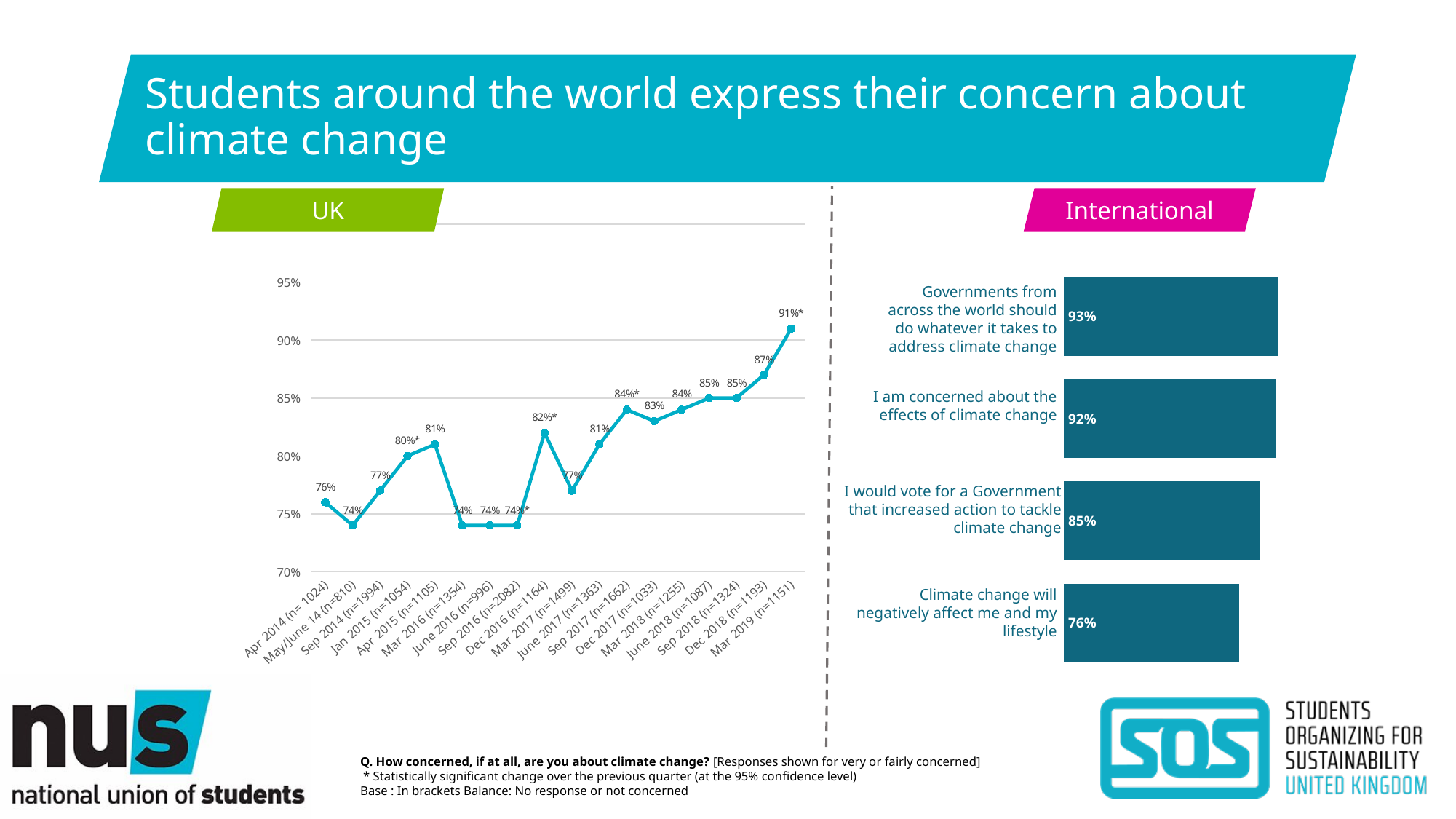
On the UK chart, which time point has the highest value? Mar 2019 On the UK chart, do values generally rise or fall from Sep 2016 to Mar 2019? Rise On the UK chart, what is the value for Mar 2019? 91% What kind of chart is the International chart? Bar chart On the UK chart, which is larger: the value for Dec 2016 or the value for Mar 2017? Dec 2016 On the International chart, what is the value for 'I am concerned about the effects of climate change'? 92% What kind of chart is the UK chart? Line chart On the UK chart, what is the value for Apr 2014? 76% On the UK chart, how many data points are plotted? 18 On the International chart, which statement has the lowest value? Climate change will negatively affect me and my lifestyle On the International chart, what is the difference between the highest and lowest values? 17 percentage points On the UK chart, what is the difference between the Mar 2019 value and the Apr 2014 value? 15 percentage points